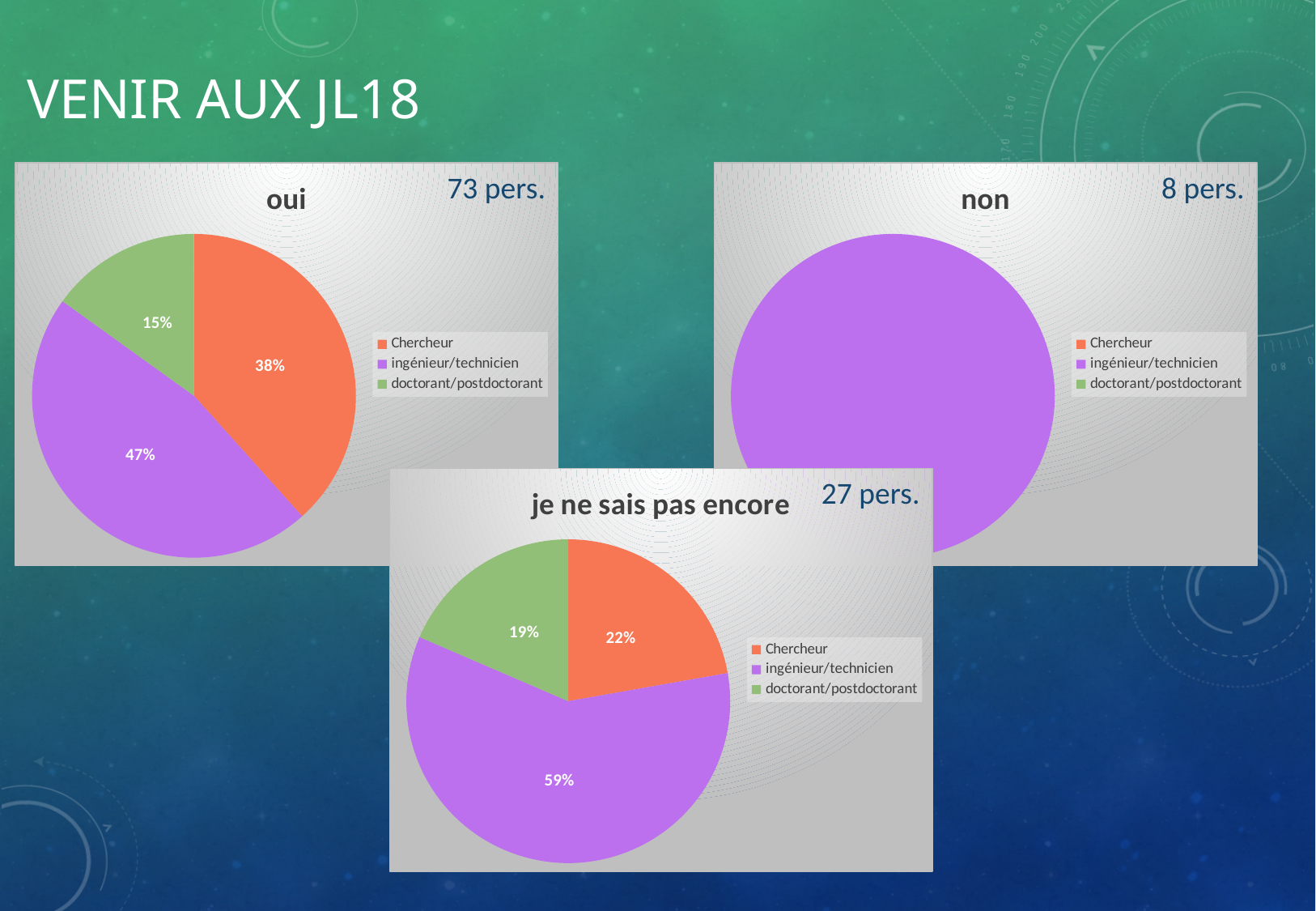
How many entries does the legend of the "non" chart list? 3 In the "non" chart, which category fills the entire pie? ingénieur/technicien In the "oui" chart, which category has the smallest slice? doctorant/postdoctorant In the "je ne sais pas encore" chart, what is the difference between the ingénieur/technicien share and the doctorant/postdoctorant share? 40% In the "je ne sais pas encore" chart, what share of the pie is Chercheur? 22% In the "oui" chart, what share of the pie is doctorant/postdoctorant? 15% In the "je ne sais pas encore" chart, which is larger, the Chercheur slice or the doctorant/postdoctorant slice? Chercheur In the "oui" chart, what share of the pie is Chercheur? 38% What kind of chart is the "oui" chart? pie chart In the "oui" chart, which category has the largest slice? ingénieur/technicien